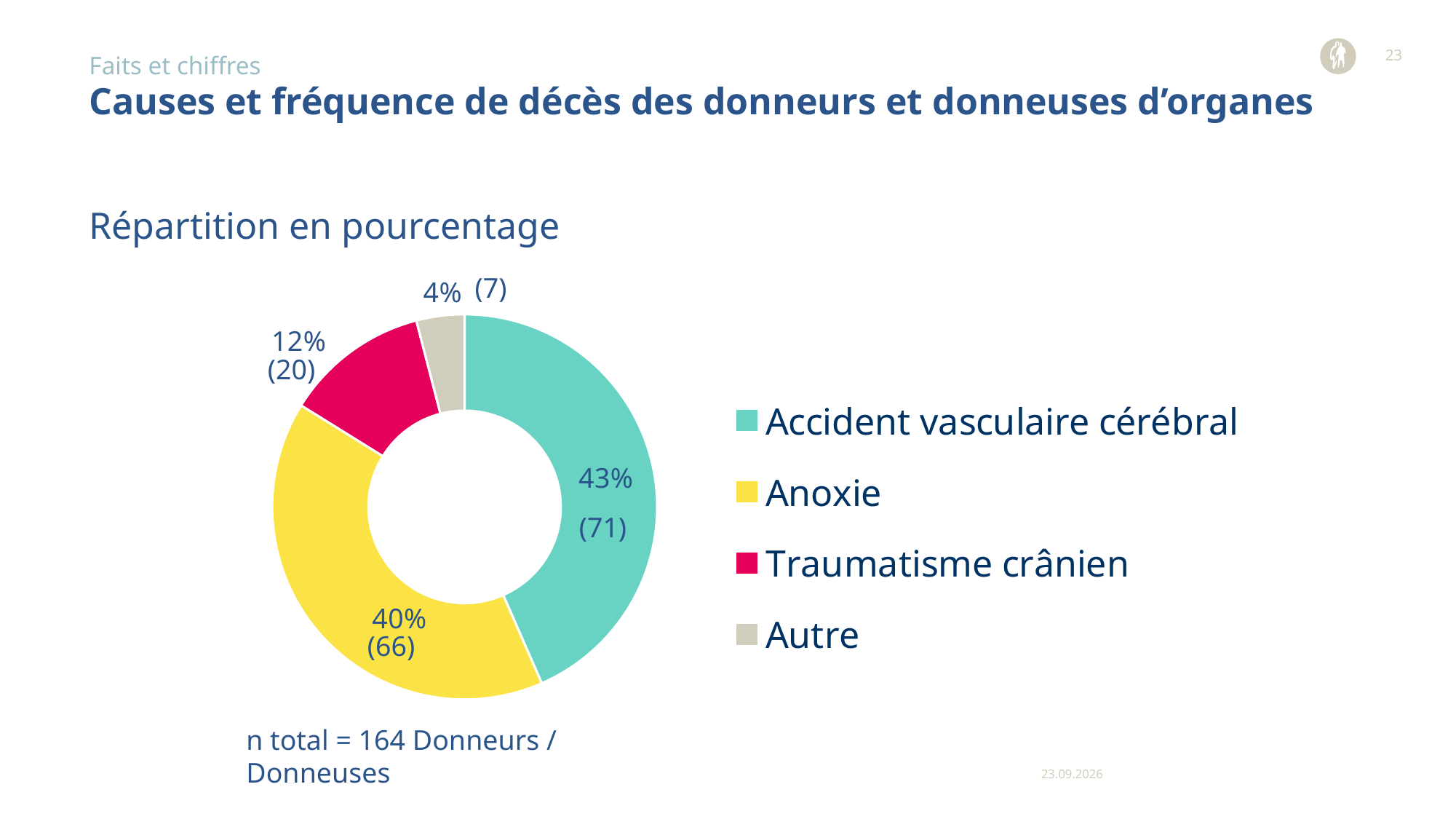
What is the total number of donors stated below the chart? 164 Which has a larger share, Traumatisme crânien or Autre? Traumatisme crânien What percentage share does Traumatisme crânien have in the pie chart? 12% What is the count shown for Autre in the pie chart? 7 What kind of chart is shown on the slide? Doughnut chart Which cause of death has the smallest share in the pie chart? Autre Which cause of death has the largest share in the pie chart? Accident vasculaire cérébral How many categories are shown in the pie chart? 4 What percentage share does Accident vasculaire cérébral have in the pie chart? 43% What is the difference in count between Accident vasculaire cérébral and Anoxie? 5 What colour represents Anoxie in the pie chart? Yellow What is the count shown for Anoxie in the pie chart? 66